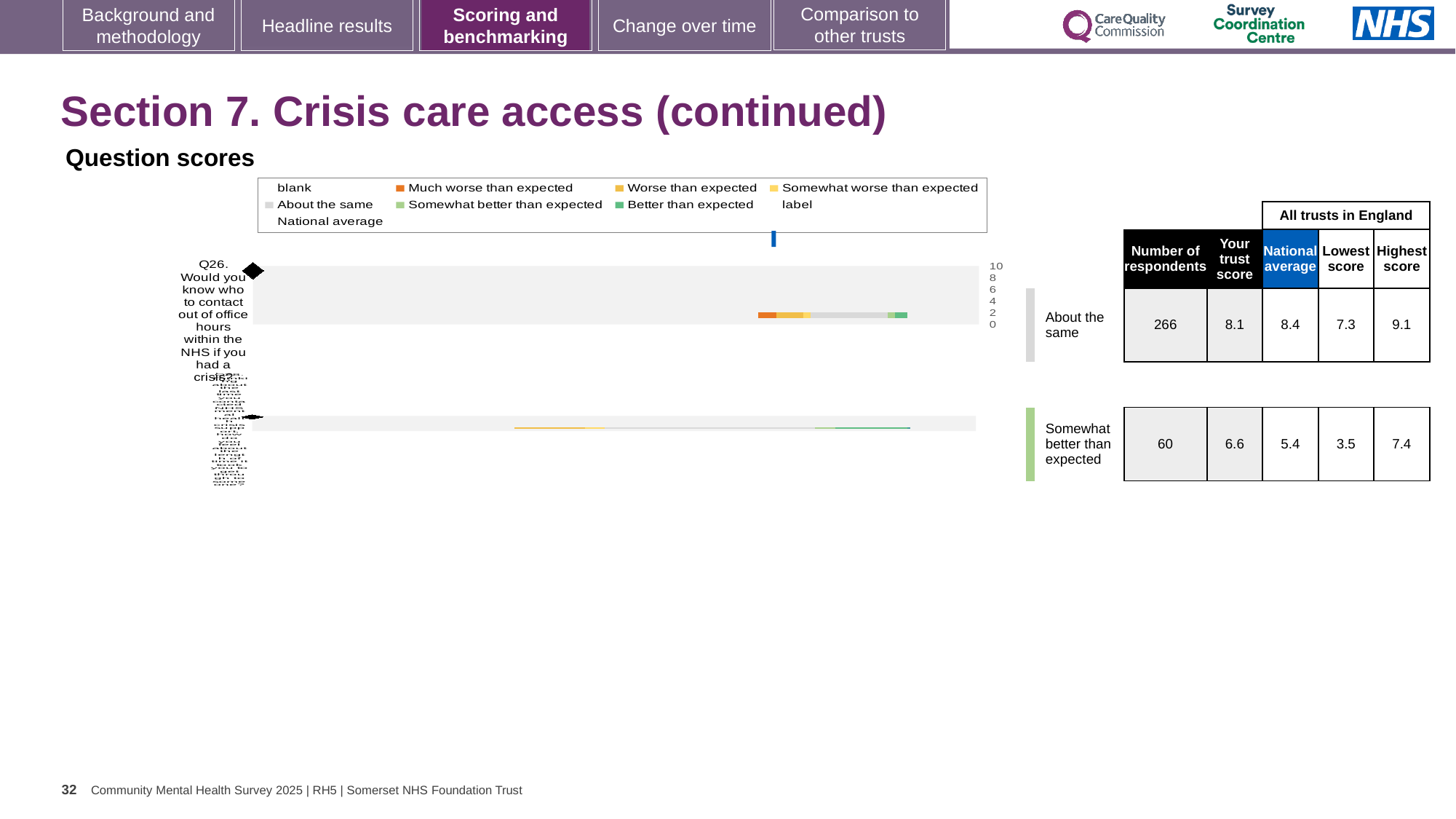
For the question rated 'Somewhat better than expected', which is larger: the trust's score or the national average? Trust score What is the number of respondents for Q26 (Would you know who to contact out of office hours within the NHS if you had a crisis?)? 266 What is the trust's score for Q26? 8.1 What is the national average score for Q26? 8.4 What is the difference between the highest and lowest scores in England for Q26? 1.8 What is the lowest score among all trusts in England for Q26? 7.3 What colour represents 'Much worse than expected' in the chart legend? Orange For the question rated 'Somewhat better than expected', what is the trust's score? 6.6 What kind of chart is used to show the question scores on this slide? Bar chart For Q26, which is larger: the trust's score or the national average? National average Which benchmark category is Q26 placed in? About the same What is the highest score among all trusts in England for Q26? 9.1